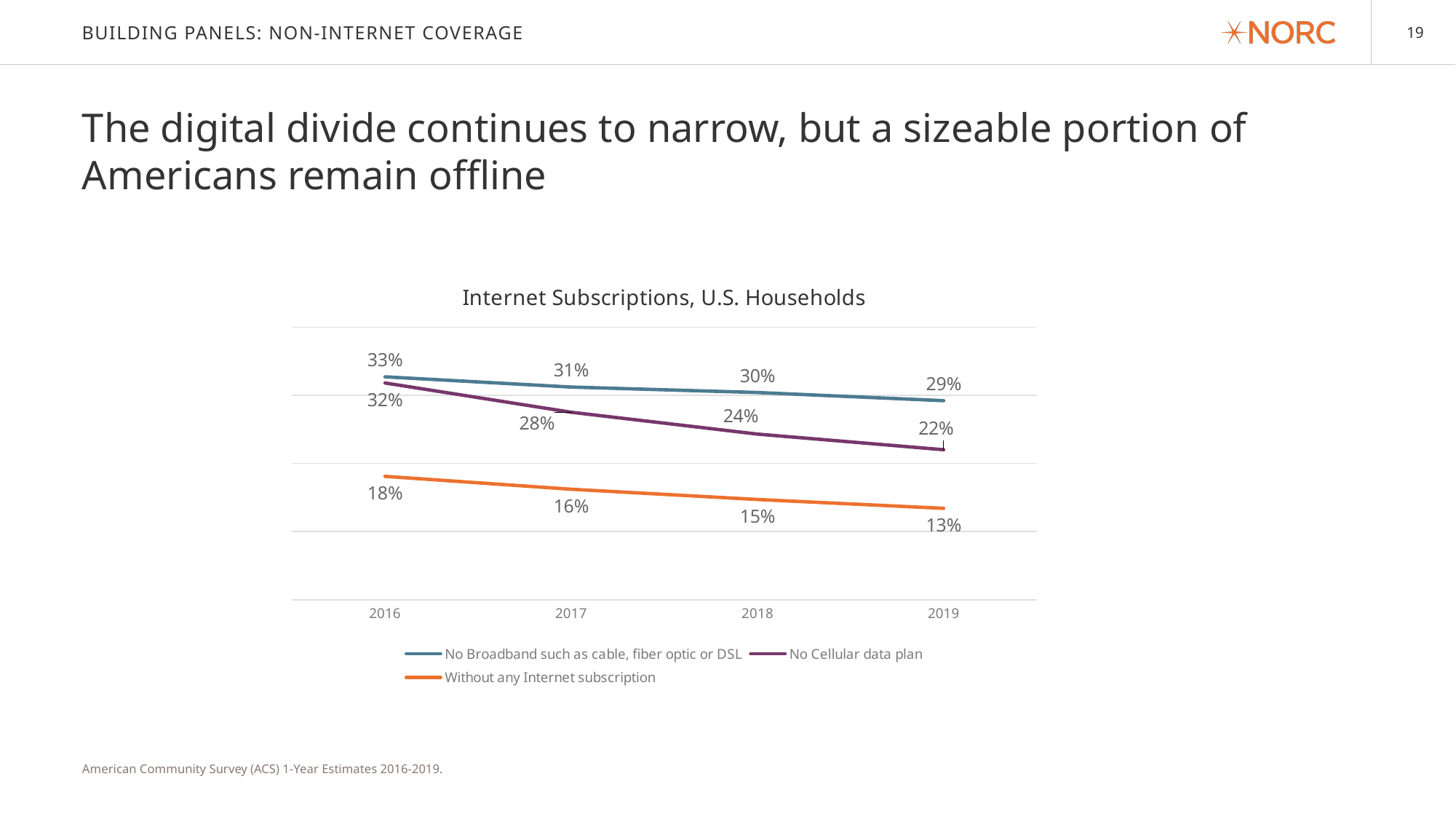
Does the 'No Cellular data plan' series rise or fall from 2016 to 2019? Fall What is the value for 'No Cellular data plan' in 2018? 24% What kind of chart is shown? Line chart What is the value for 'No Cellular data plan' in 2017? 28% In which year is the 'No Cellular data plan' series lowest? 2019 What is the value for 'No Broadband such as cable, fiber optic or DSL' in 2016? 33% How many series does the legend list? 3 Which is larger in 2018: 'No Broadband such as cable, fiber optic or DSL' or 'No Cellular data plan'? No Broadband such as cable, fiber optic or DSL How many years are shown on the x axis? 4 In which year is the 'Without any Internet subscription' series highest? 2016 What is the value for 'Without any Internet subscription' in 2019? 13% What is the difference between the 'No Broadband such as cable, fiber optic or DSL' value and the 'Without any Internet subscription' value in 2019? 16%